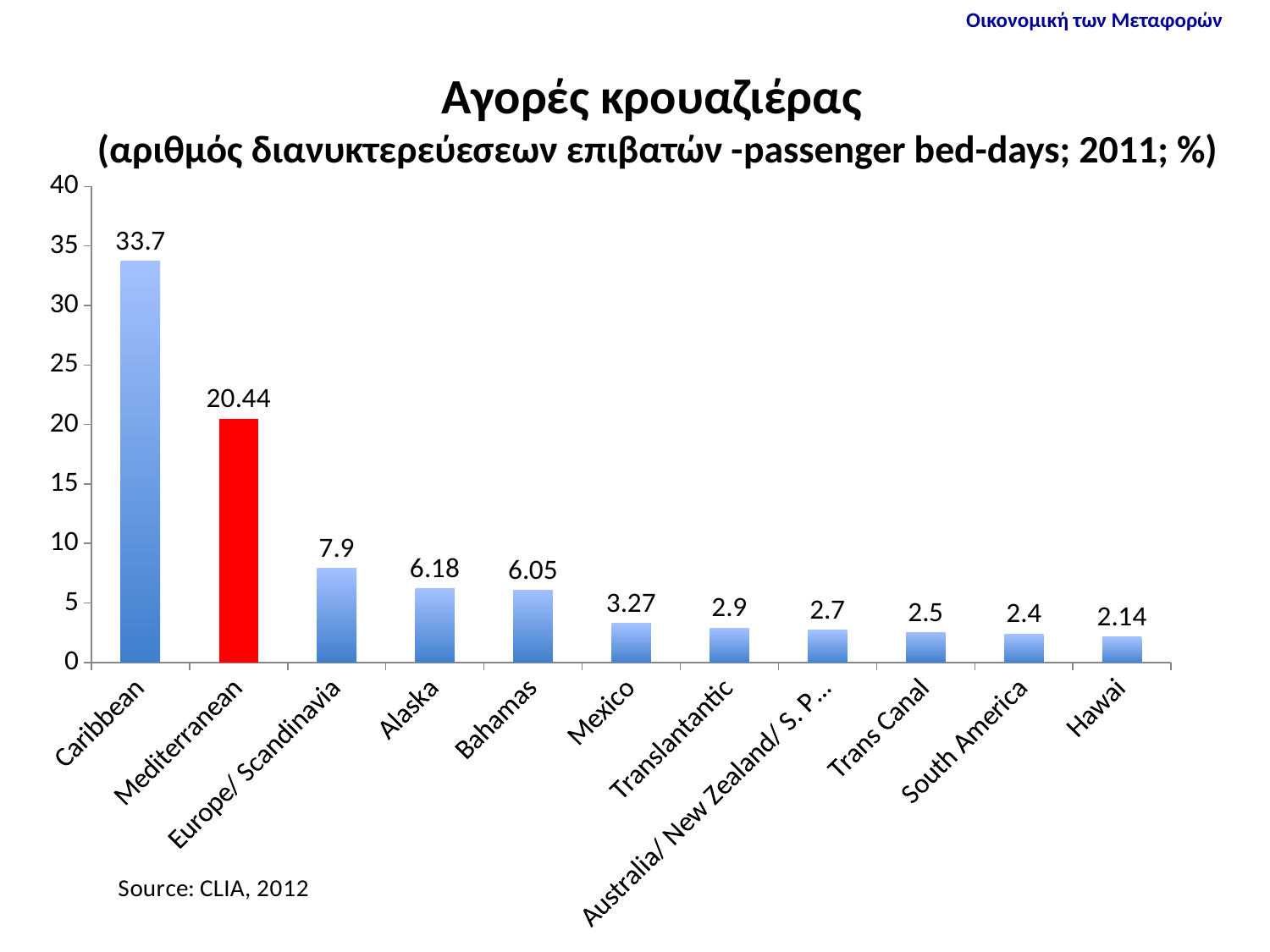
What kind of chart is shown on the slide? bar chart What is the value for Hawai? 2.14 What is the difference between the values for Caribbean and Mediterranean? 13.26 How many categories are shown on the x axis? 11 Which is larger, the value for Bahamas or the value for Mexico? Bahamas Which category has the lowest value? Hawai What is the value for Mediterranean? 20.44 What is the value for Alaska? 6.18 Which bar is coloured red? Mediterranean Which category has the highest value? Caribbean What is the value for Caribbean? 33.7 Is the value for Europe/ Scandinavia greater or less than 10? less